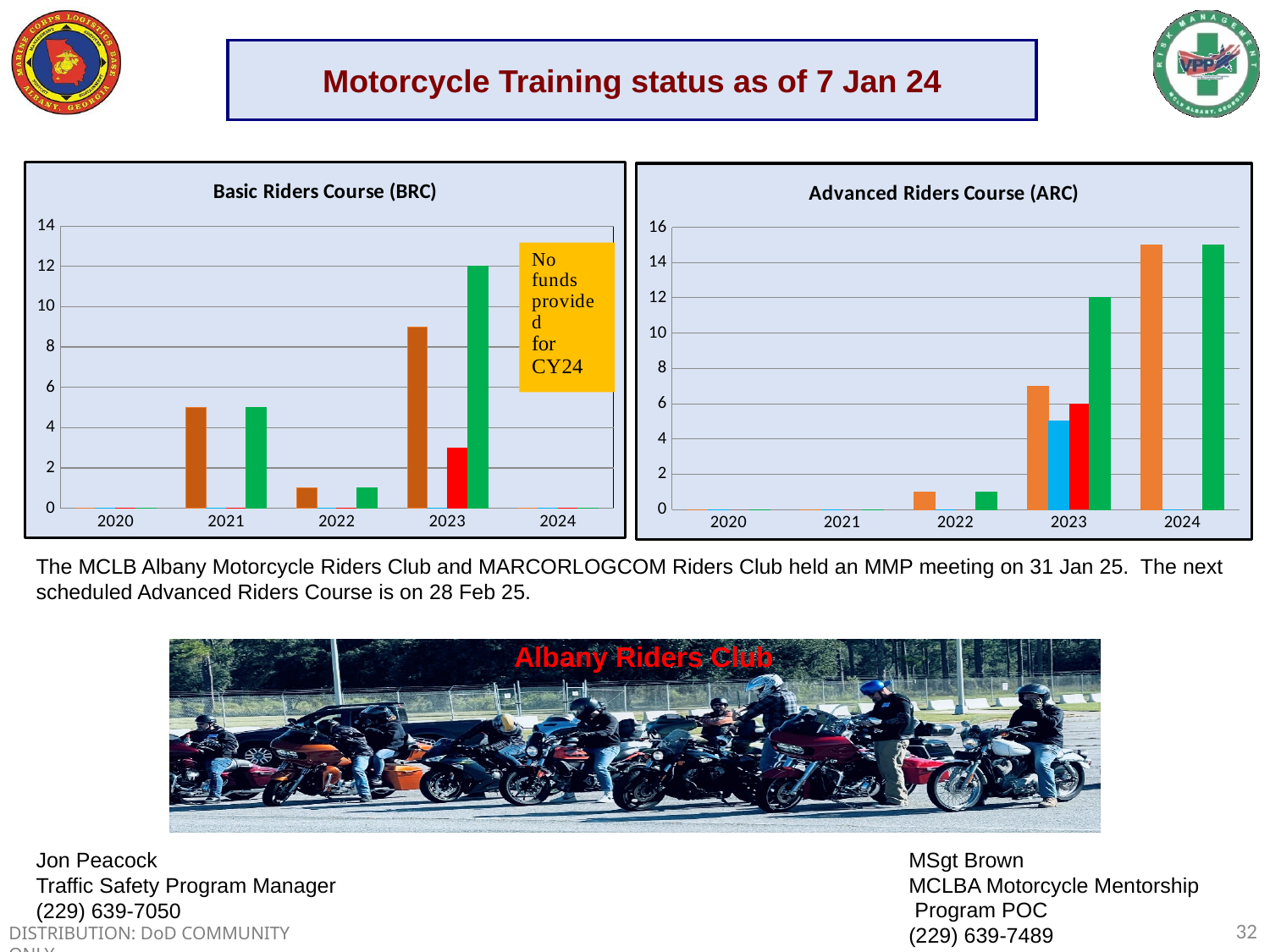
What does the yellow note on the Basic Riders Course (BRC) chart say? No funds provided for CY24 In the Basic Riders Course (BRC) chart, which year has the tallest bar? 2023 In the Advanced Riders Course (ARC) chart, is the orange bar for 2023 greater or less than 6? greater In the Advanced Riders Course (ARC) chart, which is larger: the green bar in 2023 or the green bar in 2022? 2023 How many years are shown on the x axis of the Advanced Riders Course (ARC) chart? 5 What kind of chart is the Basic Riders Course (BRC) chart? bar chart In the Basic Riders Course (BRC) chart, what is the value of the tallest bar in 2023? 12 In the Basic Riders Course (BRC) chart, is the brown bar for 2023 greater or less than 8? greater In the Advanced Riders Course (ARC) chart, what is the value of the green bar in 2023? 12